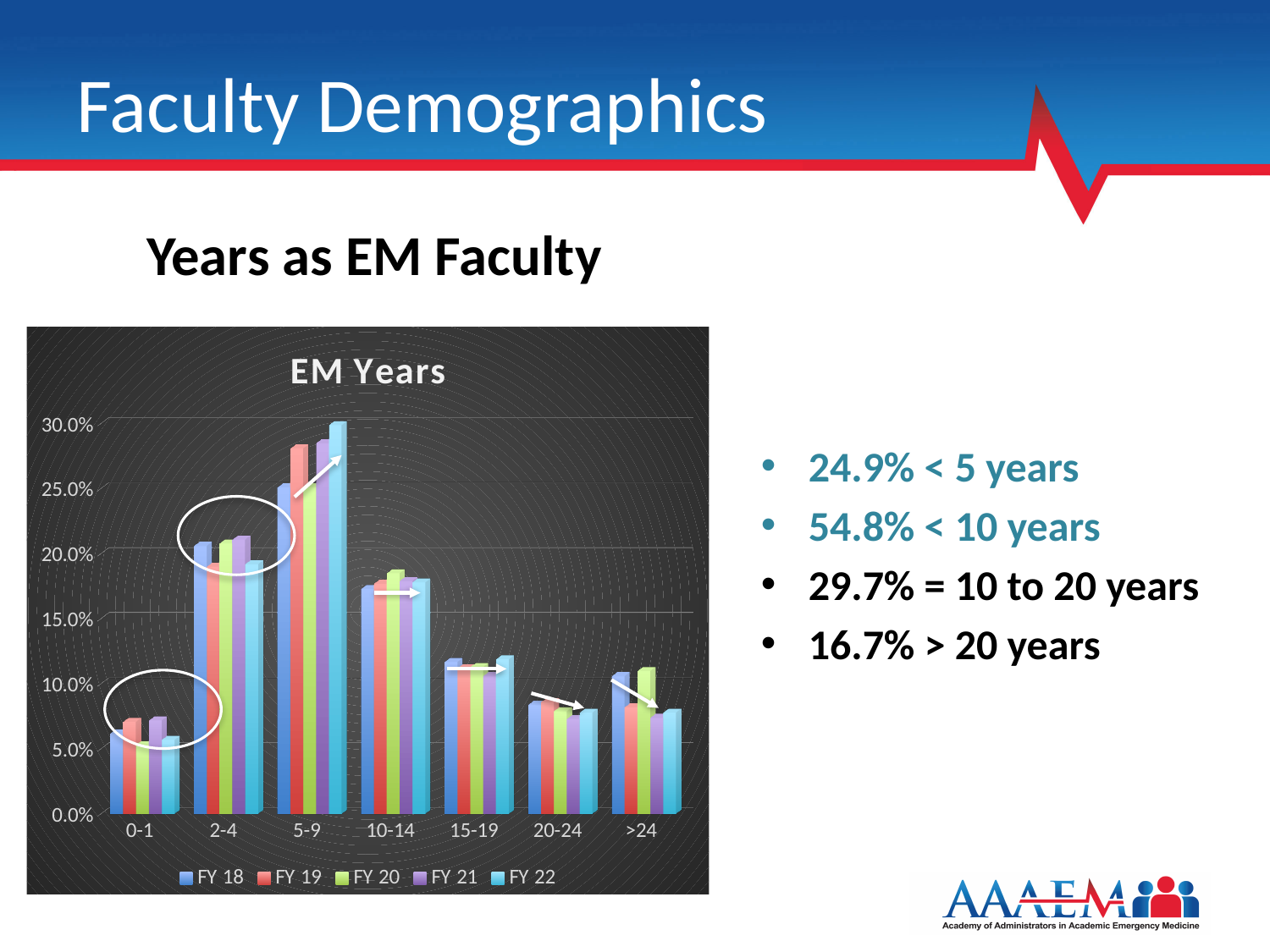
Across FY 18 to FY 22, do the values for the 5-9 category rise or fall? rise What is the title of the chart? EM Years Which category has the lowest bars in the chart? 0-1 How many year-range categories are shown on the x axis of the chart? 7 How many series does the chart legend list? 5 For FY 22, which category has the larger value: 5-9 or 10-14? 5-9 What kind of chart is shown on the slide? bar chart Is the FY 22 value for the 0-1 category greater or less than 10.0%? less Is the FY 22 value for the 20-24 category greater or less than 10.0%? less Is the FY 20 value for the 10-14 category greater or less than 15.0%? greater Which category has the highest bars in the chart? 5-9